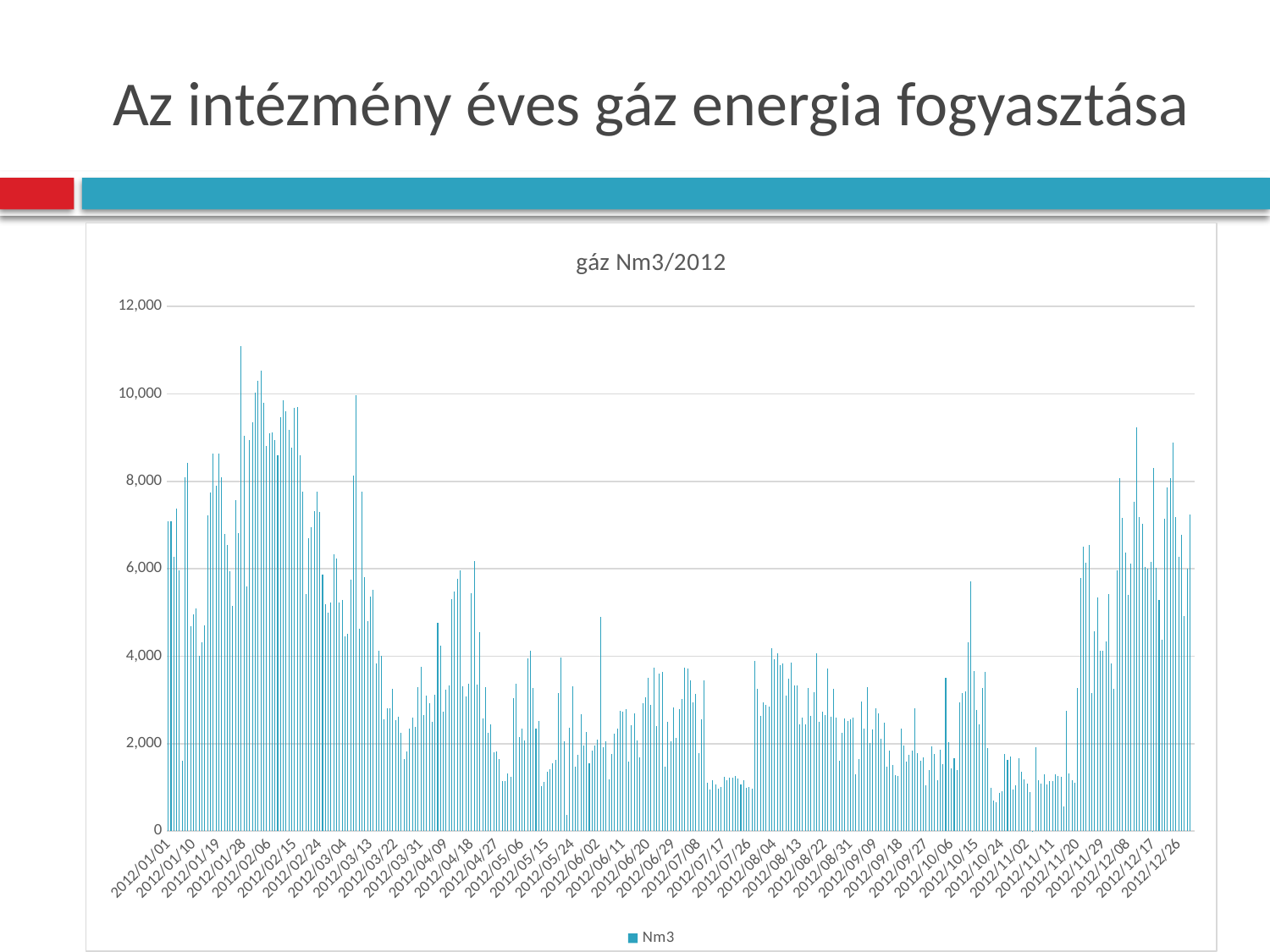
Are the values around 2012/07/17 greater or less than 2,000? less In which part of the year do the highest values occur: winter (January–February) or summer (July–August)? winter (January–February) What kind of chart is shown on the slide? bar chart How many series does the legend list? 1 What is the title of the chart? gáz Nm3/2012 Is the highest bar on the chart greater or less than 12,000? less What is the name of the series shown in the legend? Nm3 Is the value for 2012/01/01 greater or less than 6,000? greater Do the values generally rise or fall from October to December 2012? rise Do the values generally rise or fall from January to July 2012? fall